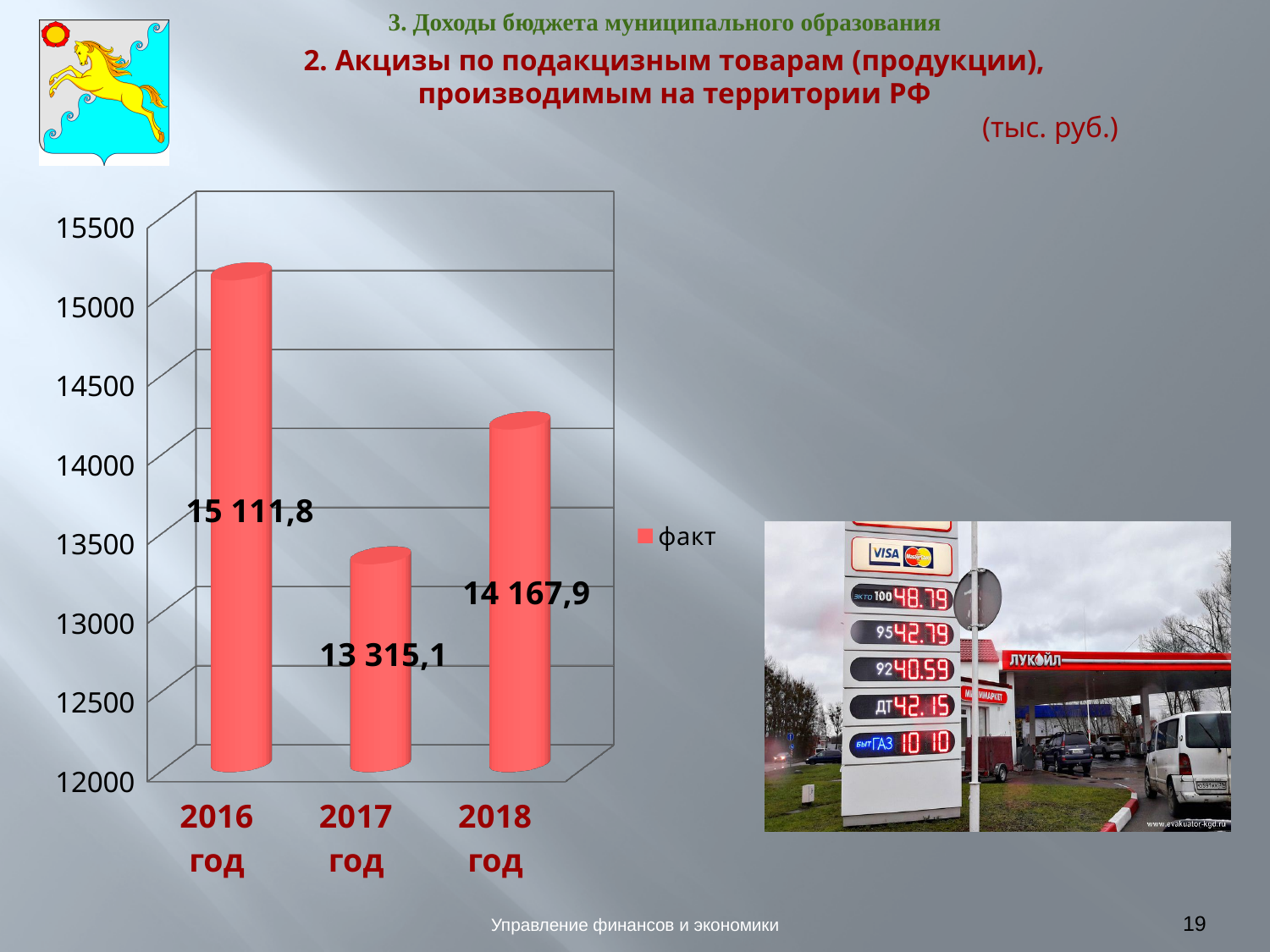
Which year has the lowest value? 2017 год What is the value for 2018 год? 14 167,9 How many years are shown on the chart? 3 What series name is listed in the chart legend? факт What is the difference between the values for 2016 год and 2017 год? 1 796,7 What is the value for 2017 год? 13 315,1 What is the value for 2016 год? 15 111,8 What kind of chart is shown on the slide? bar chart Is the value for 2017 год greater or less than 13500? less Which is larger, the value for 2018 год or the value for 2017 год? 2018 год Which year has the highest value? 2016 год What is the difference between the values for 2018 год and 2017 год? 852,8